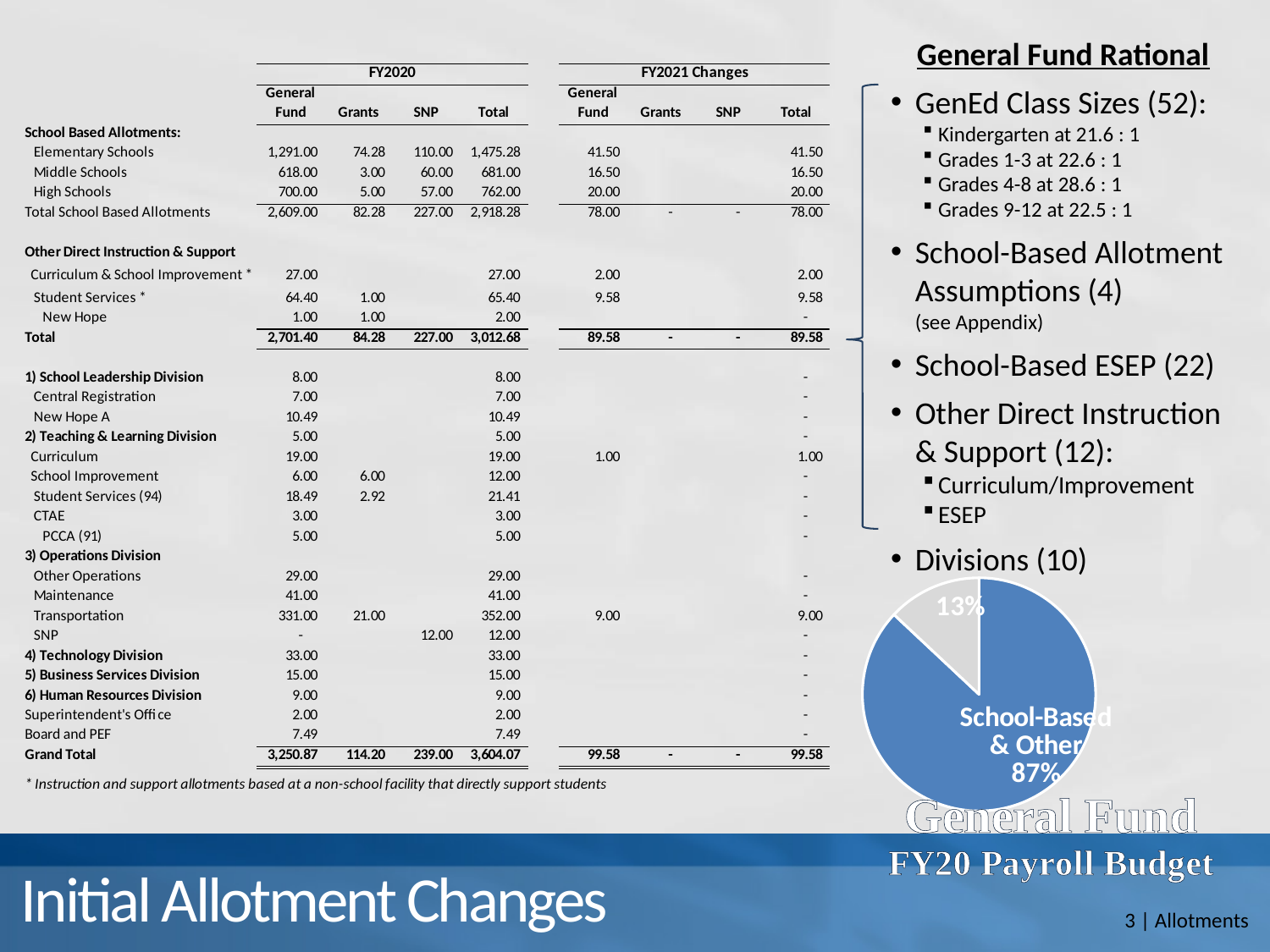
What is the difference in percentage points between the two slices of the pie chart? 74 In the pie chart, what percentage is shown on the smaller grey slice? 13% In the pie chart, what share is labelled "School-Based & Other"? 87% How many slices does the pie chart have? 2 Is the "School-Based & Other" slice of the pie chart larger or smaller than the 13% slice? larger Which slice of the pie chart is the largest? School-Based & Other What is the title shown beneath the pie chart? General Fund FY20 Payroll Budget Do the two slices of the pie chart add up to 100%? yes What colour is the "School-Based & Other" slice of the pie chart? blue What kind of chart is shown at the bottom right of the slide? pie chart